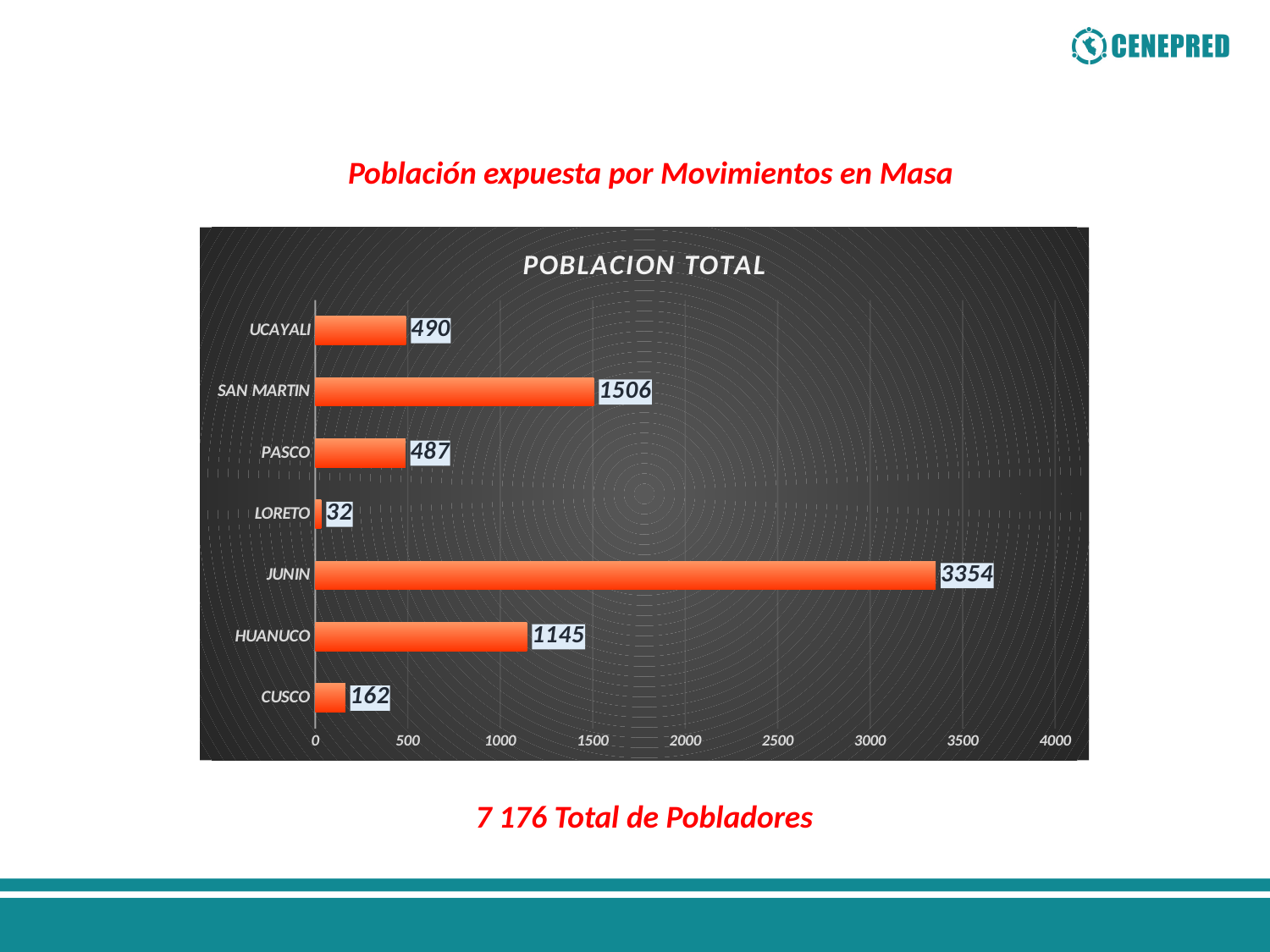
What kind of chart is shown? bar chart What is the difference between the values for JUNIN and HUANUCO? 2209 What is the difference between the values for UCAYALI and PASCO? 3 Which region has the lowest value? LORETO What is the value for SAN MARTIN? 1506 What is the title of the chart? POBLACION TOTAL Which region has the highest value? JUNIN Which is larger, the value for SAN MARTIN or the value for HUANUCO? SAN MARTIN How many regions are shown in the chart? 7 What is the value for JUNIN? 3354 What is the value for LORETO? 32 Is the value for CUSCO greater or less than 500? less